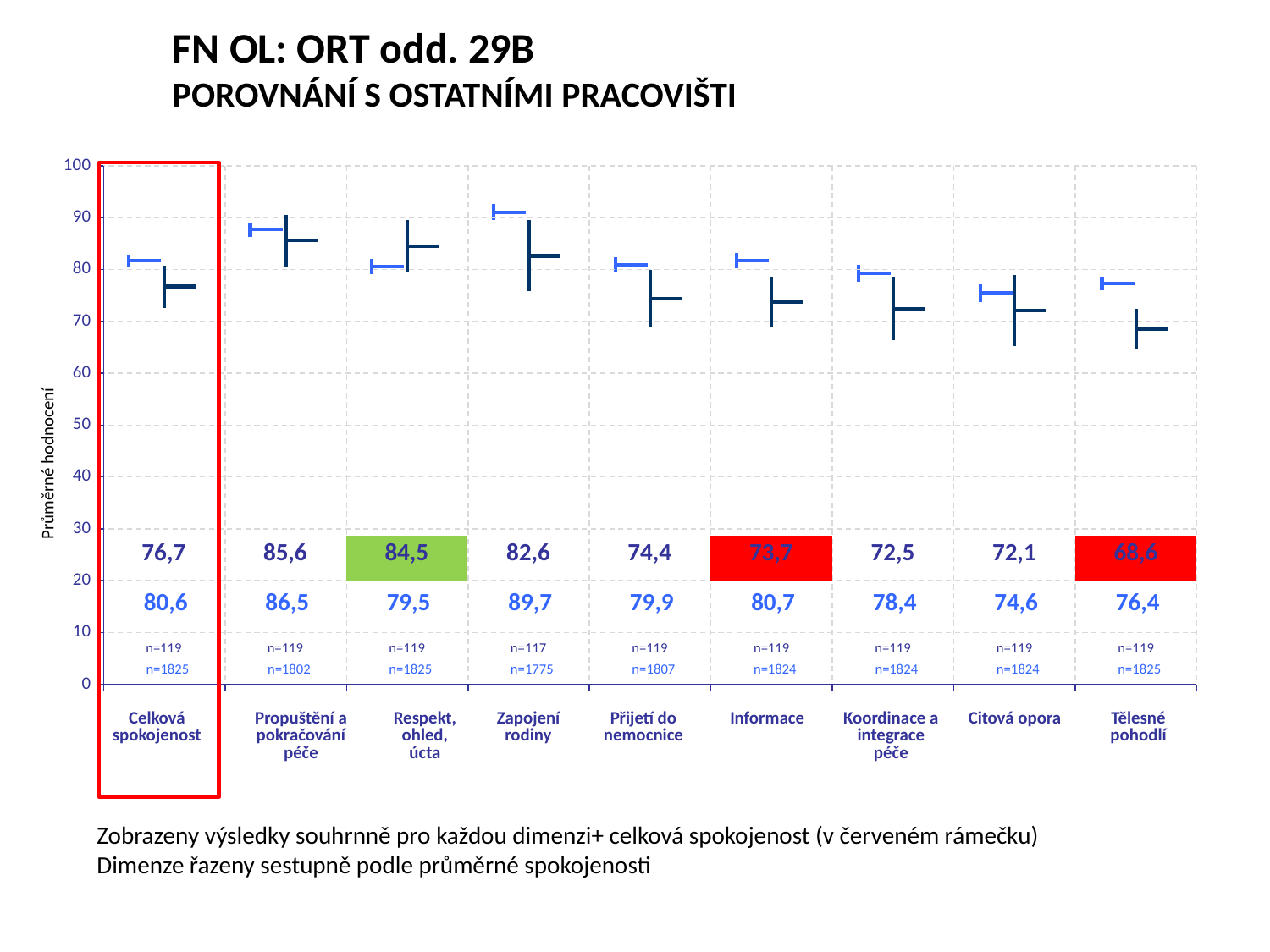
What is the dark blue value printed for Tělesné pohodlí? 68,6 For Celková spokojenost, what is the difference between the light blue value and the dark blue value? 3,9 For Respekt, ohled, úcta, which is larger: the dark blue value or the light blue value? the dark blue value (84,5) Which category is enclosed in the red frame? Celková spokojenost What is the light blue value printed for Zapojení rodiny? 89,7 Which category has the lowest dark blue value? Tělesné pohodlí (68,6) How many categories are shown along the x axis? 9 What is the first n value printed for Zapojení rodiny? n=117 For Zapojení rodiny, what is the difference between the light blue value and the dark blue value? 7,1 Which category has the highest light blue value? Zapojení rodiny (89,7) What is the dark blue value printed for Informace? 73,7 Which category has the highest dark blue value? Propuštění a pokračování péče (85,6)